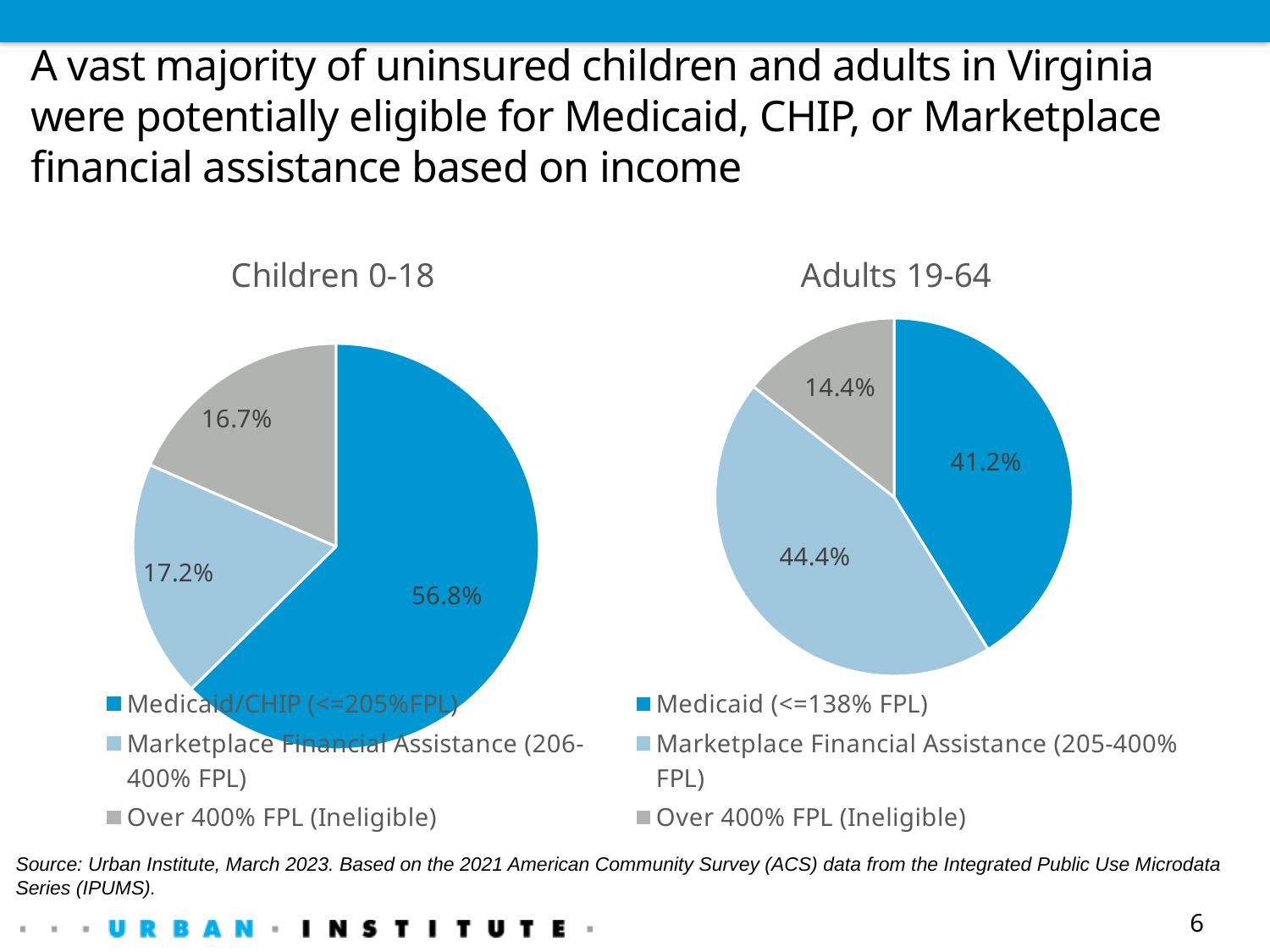
How many categories does the legend of the Adults 19-64 chart list? 3 In the Children 0-18 chart, what is the value for Marketplace Financial Assistance (206-400% FPL)? 17.2% In the Children 0-18 chart, what share of uninsured children were eligible for Medicaid/CHIP (<=205%FPL)? 56.8% In the Adults 19-64 chart, which category has the largest slice? Marketplace Financial Assistance (205-400% FPL) In the Children 0-18 chart, what is the difference between the Medicaid/CHIP (<=205%FPL) slice and the Over 400% FPL (Ineligible) slice? 40.1% In the Adults 19-64 chart, what share of uninsured adults were eligible for Marketplace Financial Assistance (205-400% FPL)? 44.4% What type of chart is used for the Children 0-18 data? Pie chart In the Children 0-18 chart, which category has the largest slice? Medicaid/CHIP (<=205%FPL) In the Adults 19-64 chart, what is the value for Over 400% FPL (Ineligible)? 14.4% In the Adults 19-64 chart, which category has the smallest slice? Over 400% FPL (Ineligible) Which is larger: the Medicaid/CHIP slice in the Children 0-18 chart or the Medicaid slice in the Adults 19-64 chart? Children 0-18 Medicaid/CHIP In the Adults 19-64 chart, what is the difference between the Medicaid (<=138% FPL) slice and the Over 400% FPL (Ineligible) slice? 26.8%